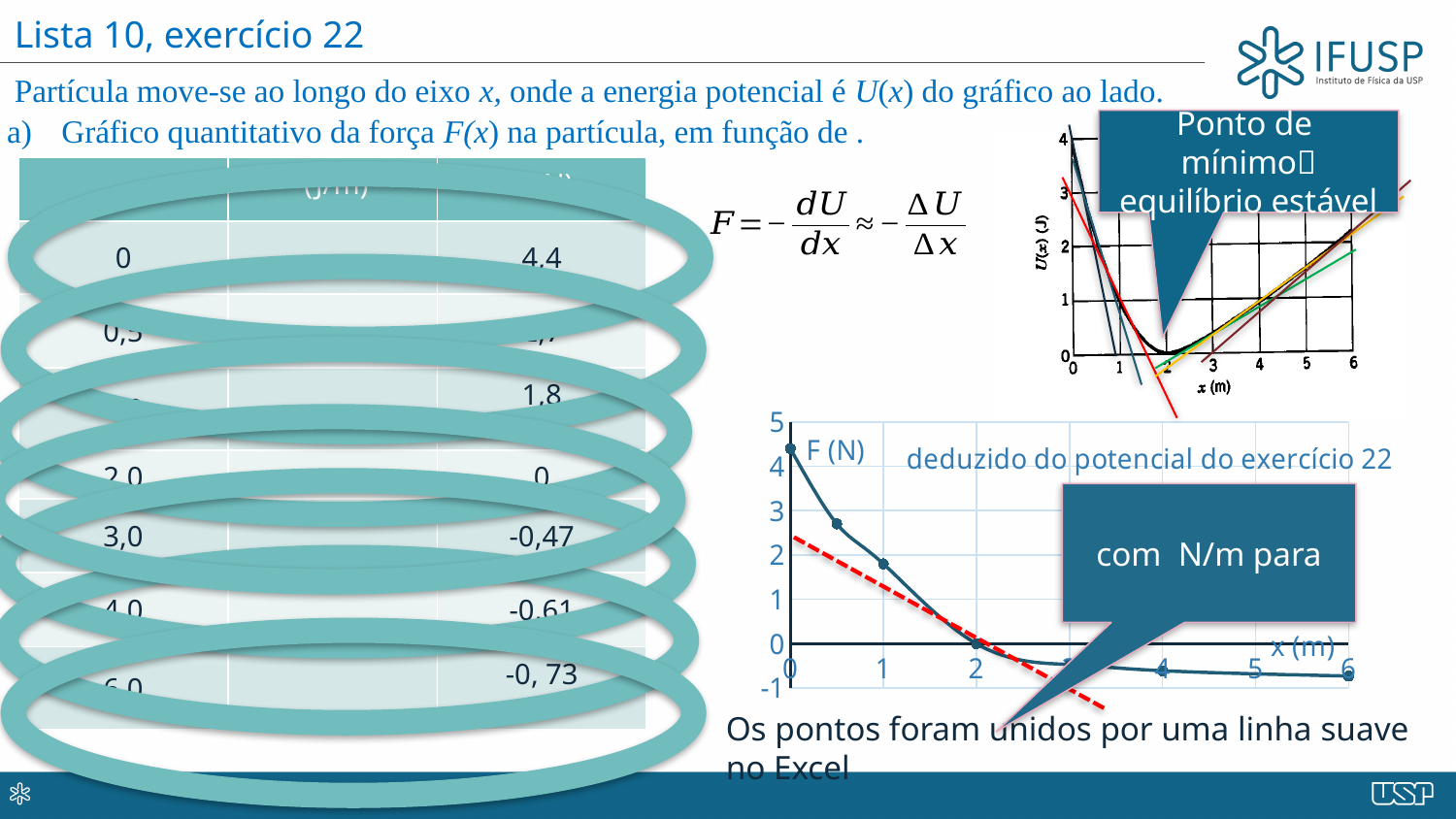
In the F (N) chart, is the value at x = 6 greater or less than -1? greater In the F (N) chart, which is larger: the value at x = 0 or the value at x = 1? x = 0 In the F (N) chart, is the value at x = 3 greater or less than 0? less In the F (N) chart, is the value at x = 0.5 greater or less than 3? less In the F (N) chart, do the values rise or fall as x increases from 0 to 6? fall What is the label on the vertical axis of the F versus x chart? F (N) In the F (N) chart, at which x value is the force highest? 0 What kind of chart is the F (N) versus x (m) chart on the slide? line chart What is the label on the horizontal axis of the F versus x chart? x (m) In the F (N) chart, which is larger: the value at x = 0.5 or the value at x = 2? x = 0.5